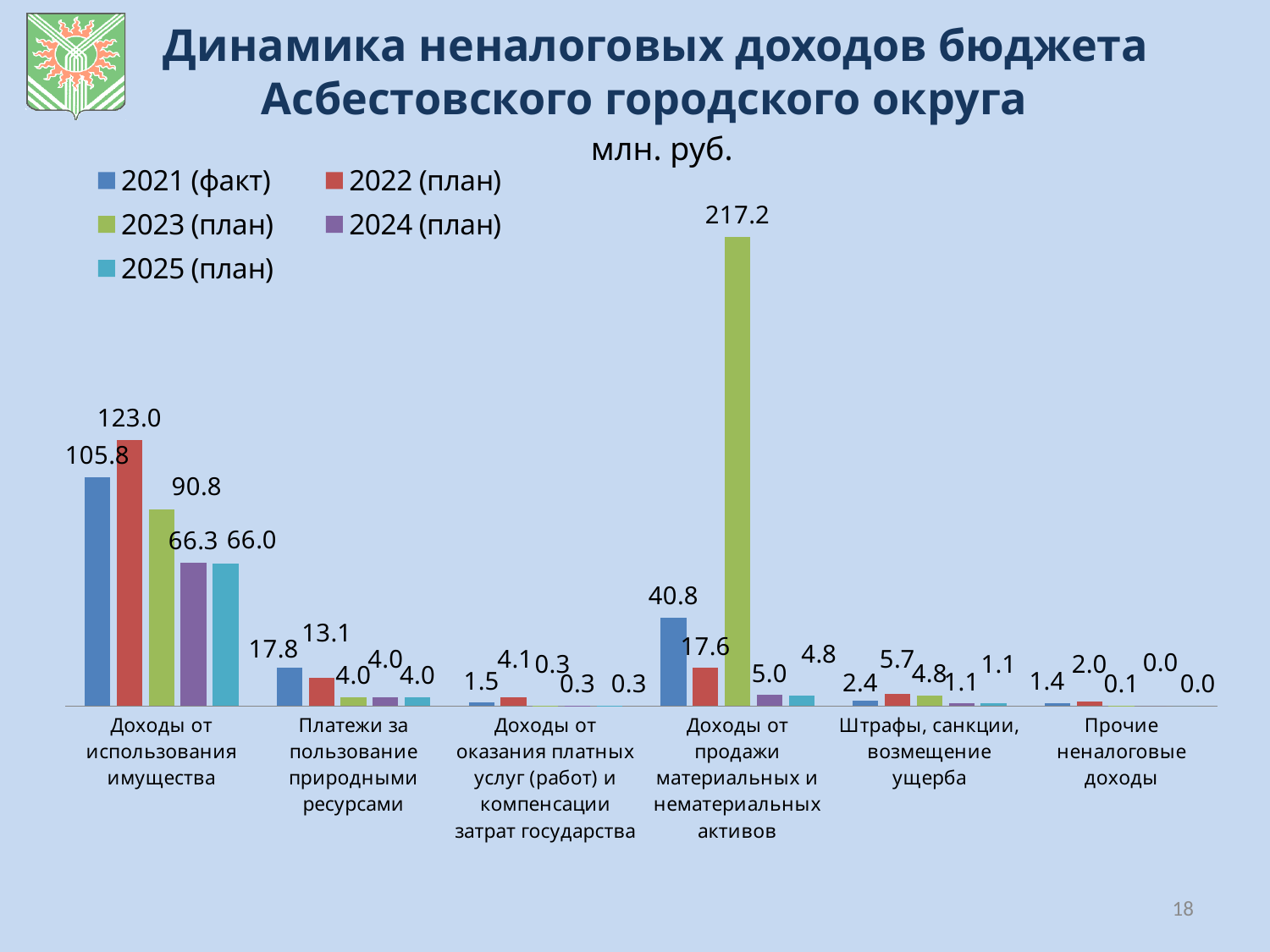
What type of chart is shown on the slide? bar chart How many categories are shown on the x axis? 6 How many series does the legend list? 5 Which year has the lowest value in the category 'Платежи за пользование природными ресурсами'? 2023 (план), 2024 (план) and 2025 (план) are tied at 4.0 What unit of measurement is stated above the chart? млн. руб. What is the value for 2025 (план) in the category 'Штрафы, санкции, возмещение ущерба'? 1.1 What is the value for 2023 (план) in the category 'Доходы от продажи материальных и нематериальных активов'? 217.2 Which is larger in the category 'Доходы от продажи материальных и нематериальных активов': the 2021 (факт) value or the 2022 (план) value? 2021 (факт) Which series is shown in green in the legend? 2023 (план) What is the value for 2021 (факт) in the category 'Доходы от использования имущества'? 105.8 Which year has the highest value in the category 'Доходы от использования имущества'? 2022 (план) What is the difference between the 2022 (план) and 2021 (факт) values in the category 'Доходы от использования имущества'? 17.2